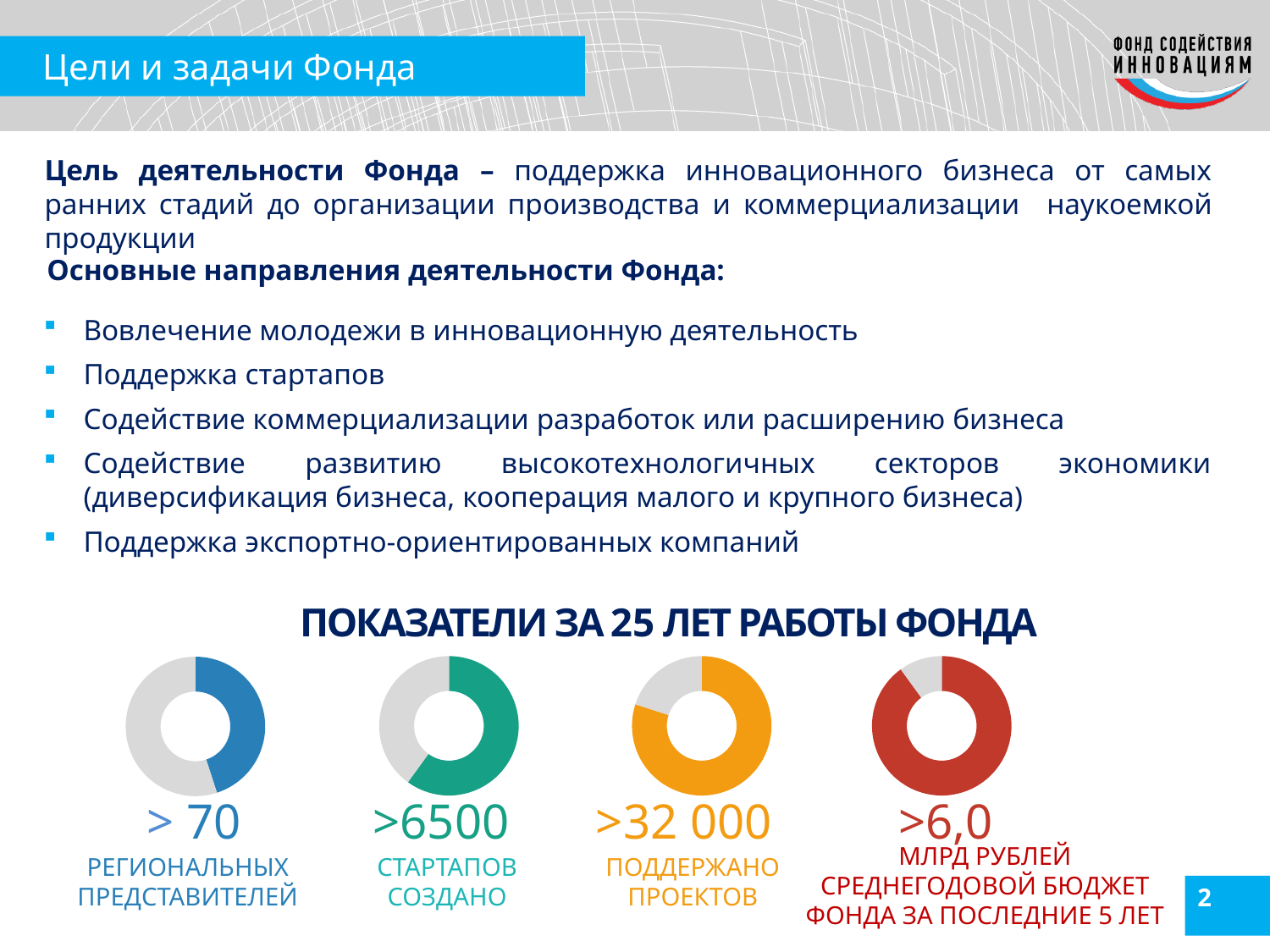
What figure is printed under the red donut chart for the fund's average annual budget over the last 5 years? >6,0 млрд рублей What figure is printed under the blue donut chart for 'РЕГИОНАЛЬНЫХ ПРЕДСТАВИТЕЛЕЙ'? > 70 Which donut chart's figure is larger: 'СТАРТАПОВ СОЗДАНО' or 'ПОДДЕРЖАНО ПРОЕКТОВ'? ПОДДЕРЖАНО ПРОЕКТОВ How many donut charts are shown on the slide? 4 What colour is the donut chart for 'ПОДДЕРЖАНО ПРОЕКТОВ'? Orange Which donut chart has the smallest filled (coloured) portion of its ring? The blue one (> 70 региональных представителей) What figure is printed under the orange donut chart for 'ПОДДЕРЖАНО ПРОЕКТОВ'? >32 000 What figure is printed under the green donut chart for 'СТАРТАПОВ СОЗДАНО'? >6500 Which donut chart has the largest filled (coloured) portion of its ring? The red one (>6,0 млрд рублей) What kind of charts are shown under the heading 'ПОКАЗАТЕЛИ ЗА 25 ЛЕТ РАБОТЫ ФОНДА'? Donut (ring) charts What is the title above the four donut charts? ПОКАЗАТЕЛИ ЗА 25 ЛЕТ РАБОТЫ ФОНДА